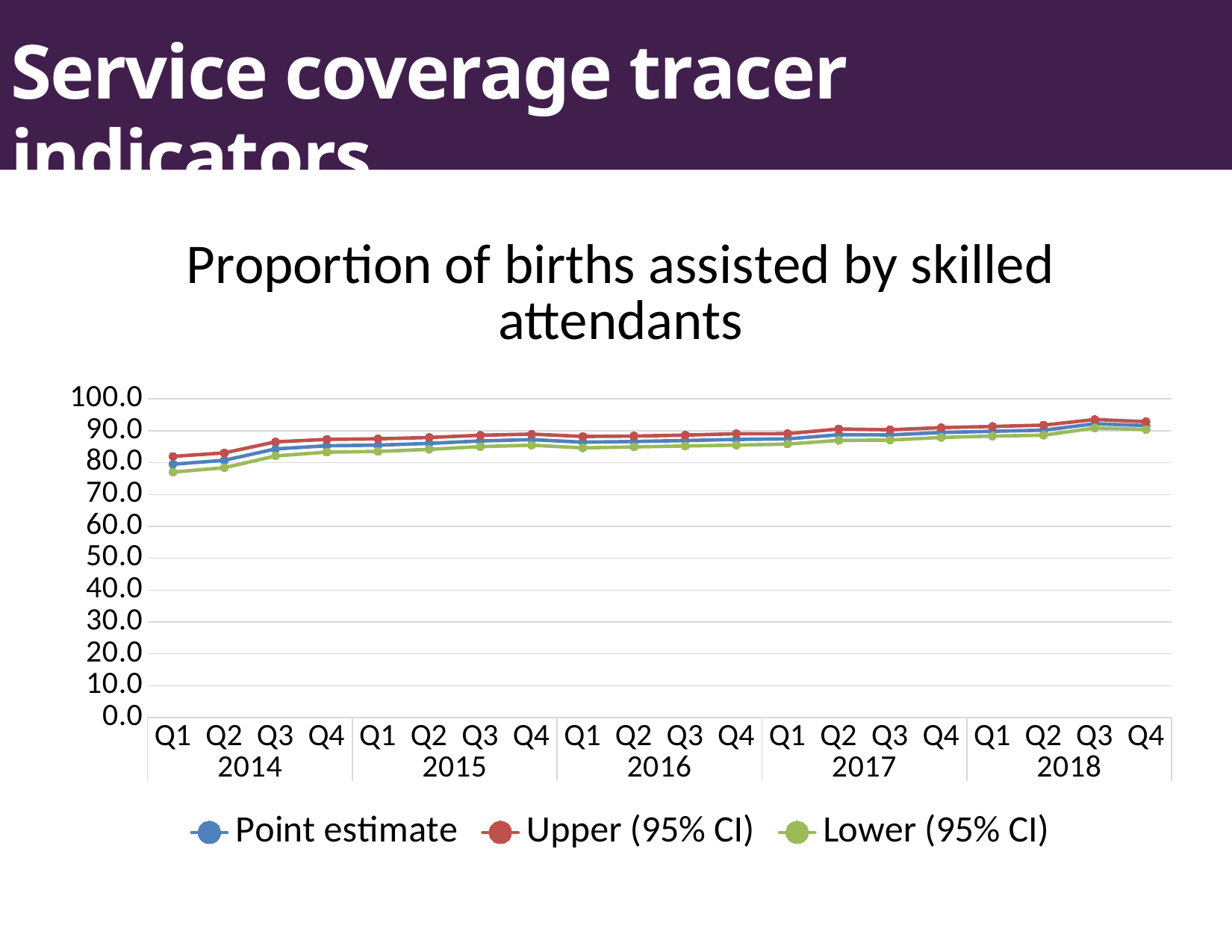
What is the title of the chart? Proportion of births assisted by skilled attendants Do the Point estimate values generally rise or fall from Q1 2014 to Q4 2018? Rise In which quarter is the Point estimate lowest? Q1 2014 Is the Lower (95% CI) value for Q1 2014 greater or less than 80? less Is the Point estimate for Q1 2016 greater or less than 80? greater For Q4 2018, which is larger: the Upper (95% CI) value or the Lower (95% CI) value? Upper (95% CI) Is the Lower (95% CI) value for Q1 2014 greater or less than 70? greater Which series is drawn in red? Upper (95% CI) How many quarterly data points are plotted for each series? 20 How many series does the legend list? 3 What kind of chart is shown on the slide? Line chart